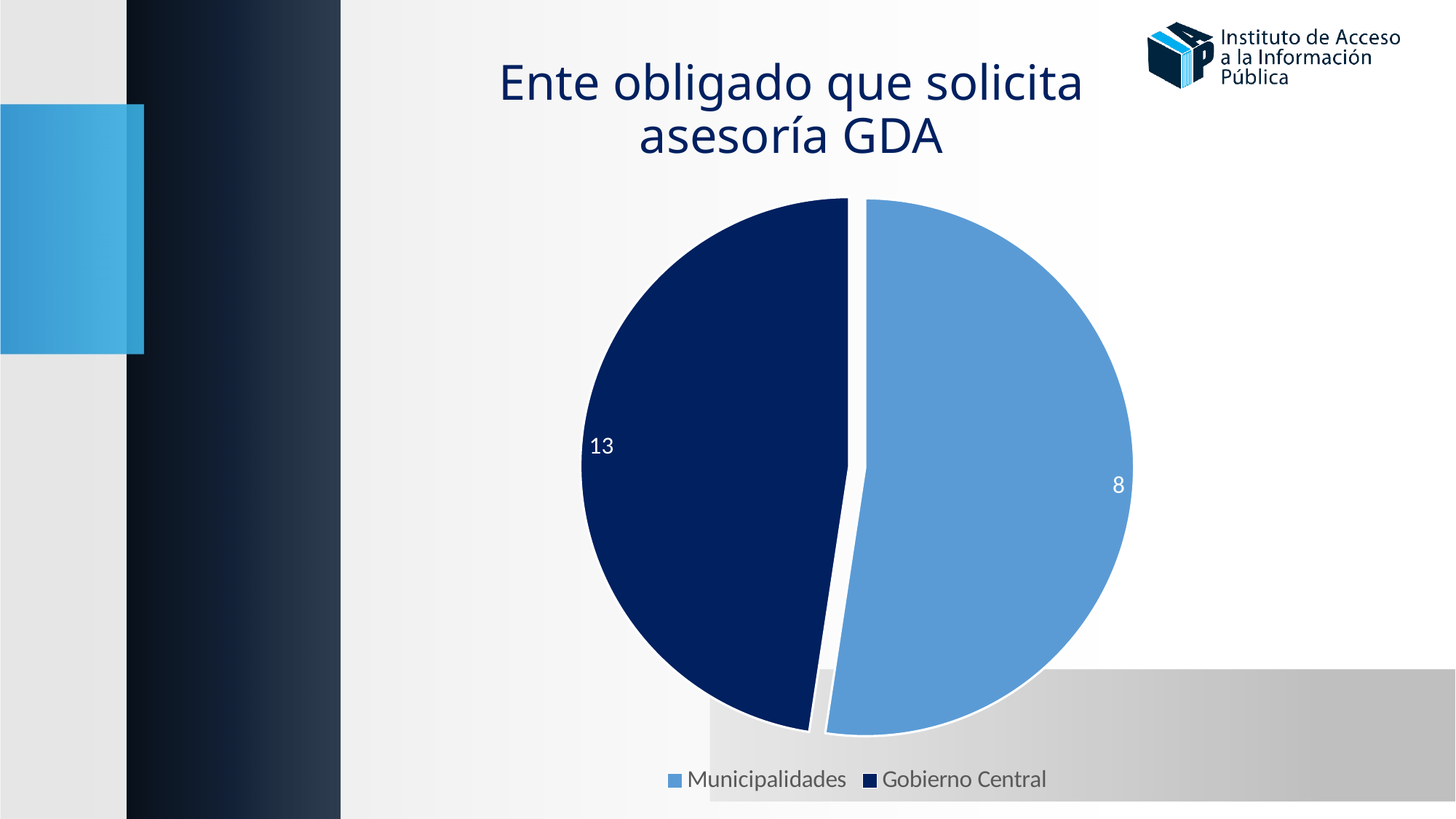
What type of chart is shown on the slide? pie chart What is the value for Municipalidades? 8 How many categories does the pie chart show? 2 What is the difference between the values for Gobierno Central and Municipalidades? 5 What is the value for Gobierno Central? 13 What is the title of the chart? Ente obligado que solicita asesoría GDA Which colour represents Gobierno Central in the chart? dark blue What is the total of all slices in the pie chart? 21 Which is larger, the value for Municipalidades or the value for Gobierno Central? Gobierno Central How many entries does the legend list? 2 Which category has the highest value? Gobierno Central Which category has the lowest value? Municipalidades